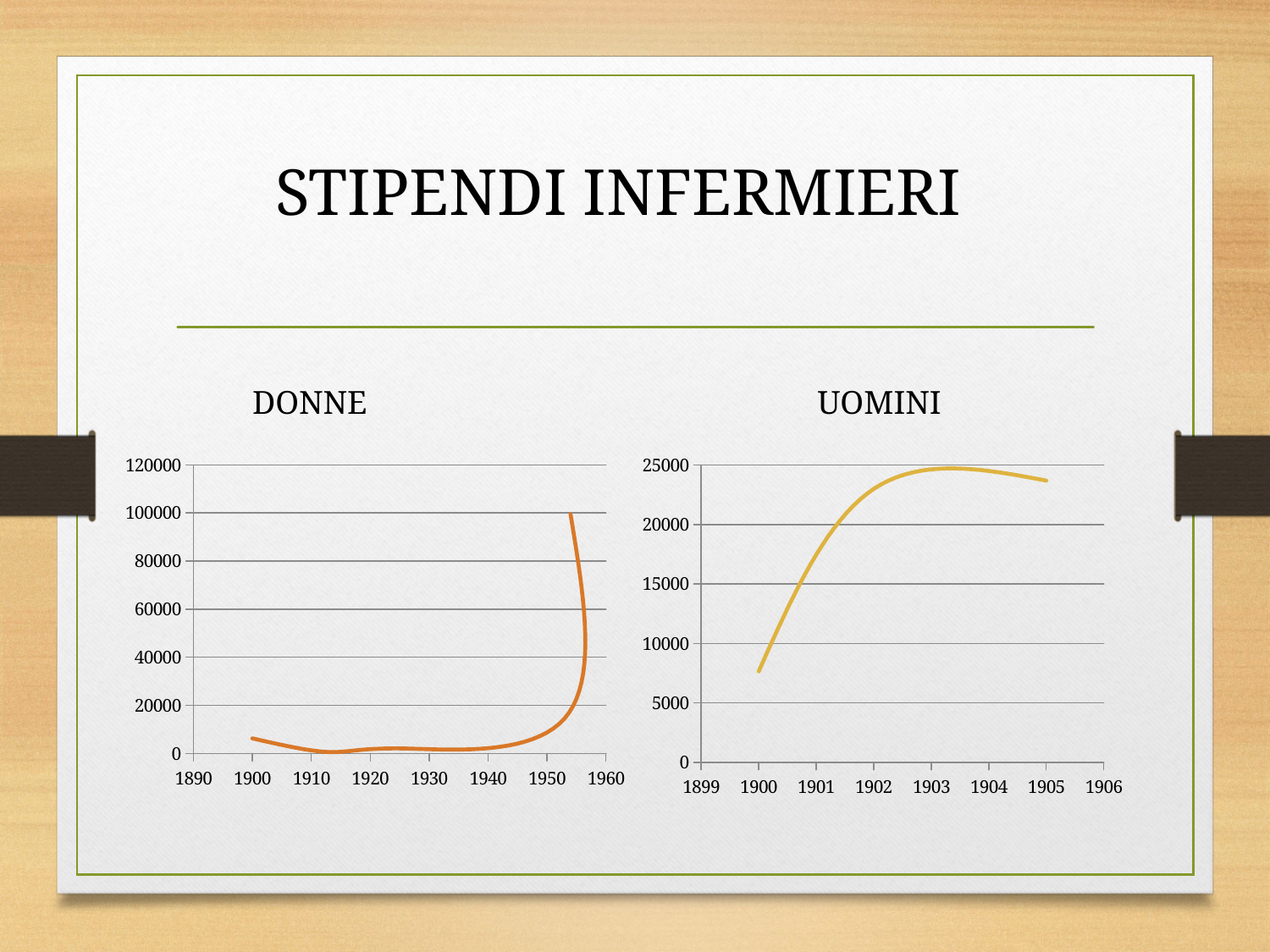
In the DONNE chart, is the value at 1900 greater or less than 20000? less In the DONNE chart, is the highest value reached by the line greater or less than 80000? greater In the UOMINI chart, is the value at 1905 greater or less than 20000? greater In the UOMINI chart, which year has the lowest value? 1900 What kind of chart is the DONNE chart? line chart What are the titles of the two charts on the slide? DONNE and UOMINI In the DONNE chart, do the values rise or fall between 1940 and 1955? rise What kind of chart is the UOMINI chart? line chart In the UOMINI chart, which is larger, the value at 1900 or the value at 1905? 1905 In the UOMINI chart, do the values rise or fall between 1900 and 1903? rise